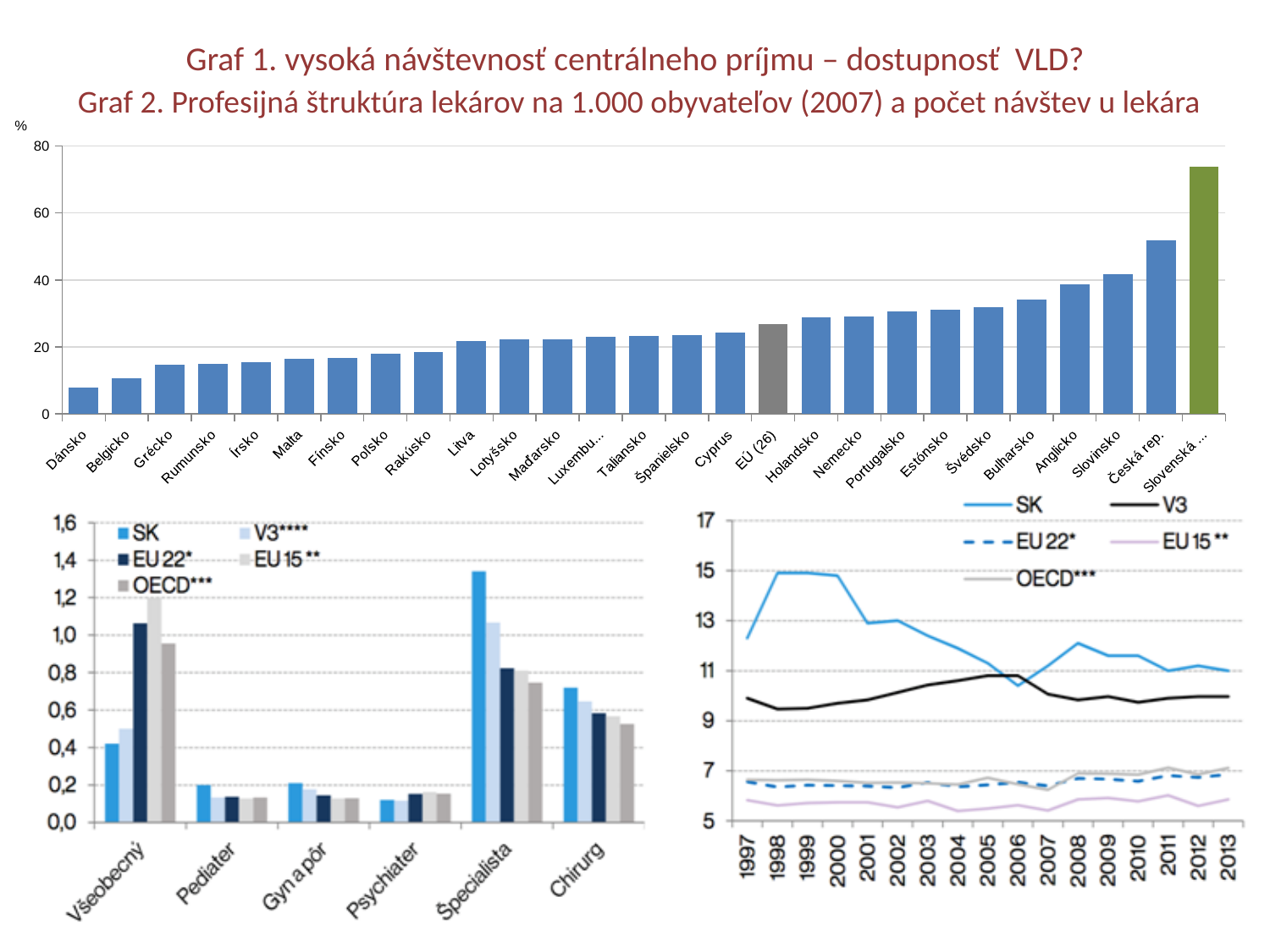
In the bottom-right chart, is the SK value for 1998 greater or less than 13? greater In the top bar chart (Graf 1), which country has the lowest value? Dánsko In the bottom-left chart, how many categories are shown on the x axis? 6 In the top bar chart (Graf 1), do the values generally rise or fall from left to right along the x axis? rise In the bottom-left chart, how many series does the legend list? 5 In the top bar chart (Graf 1), is the value for Česká rep. greater or less than 40? greater In the top bar chart (Graf 1), which country has the highest value? Slovenská ... In the top bar chart (Graf 1), how many countries/categories are shown? 27 In the top bar chart (Graf 1), is the value for Dánsko greater or less than 20? less In the top bar chart (Graf 1), which is larger, the value for Slovinsko or the value for Belgicko? Slovinsko What kind of chart is the bottom-right chart? line chart In the bottom-left chart, for which category is the SK bar the highest? Špecialista